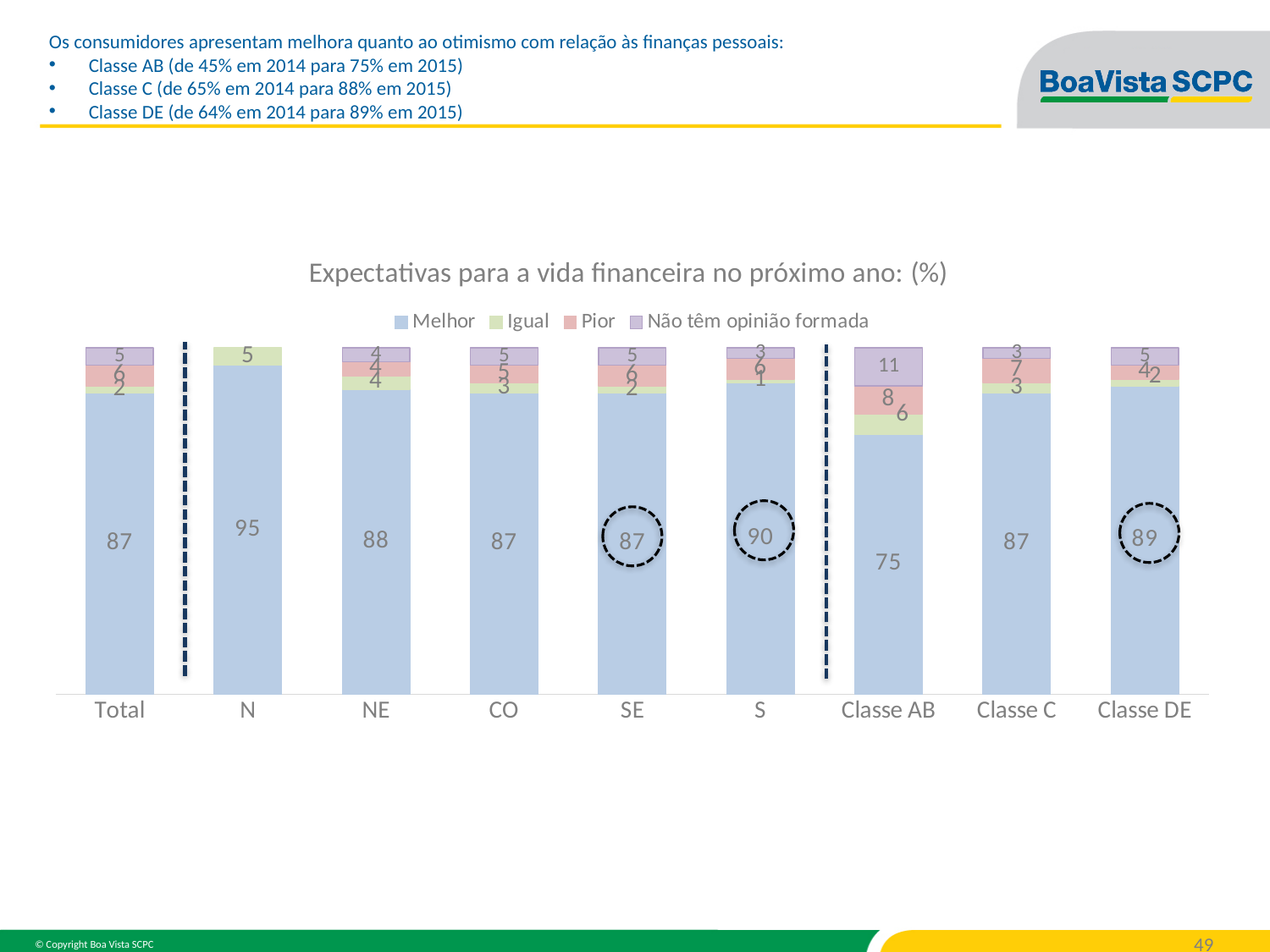
How many categories are shown on the x axis? 9 What kind of chart is shown on the slide? Stacked bar chart What is the title of the chart? Expectativas para a vida financeira no próximo ano: (%) What is the difference between the Melhor value for N and the Melhor value for Classe AB? 20 What is the 'Não têm opinião formada' value for Classe AB? 11 Which category has the lowest Melhor value? Classe AB What is the Melhor value for Classe DE? 89 How many series does the legend list? 4 What is the Melhor value for N? 95 Which category has the highest Melhor value? N What is the Melhor value for Classe AB? 75 Which has a larger Melhor value, S or NE? S